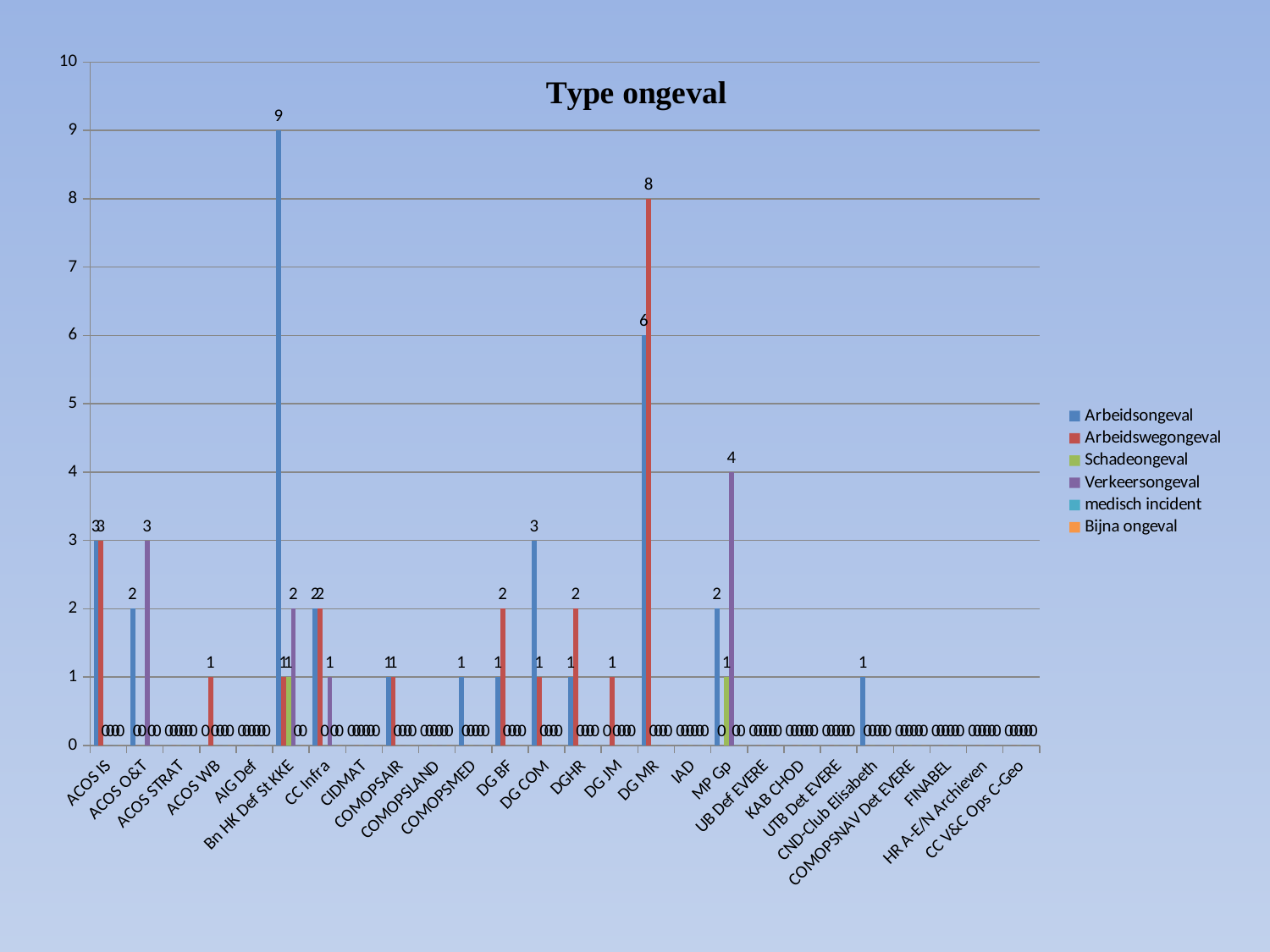
Which category has the highest Arbeidsongeval value? Bn HK Def St KKE What is the Arbeidsongeval value for Bn HK Def St KKE? 9 For DG MR, what is the difference between the Arbeidswegongeval value and the Arbeidsongeval value? 2 What is the Verkeersongeval value for MP Gp? 4 What kind of chart is shown on the slide? bar chart How many series does the legend list? 6 Which is larger: the Arbeidsongeval value for Bn HK Def St KKE or the Arbeidswegongeval value for DG MR? Arbeidsongeval for Bn HK Def St KKE Which category has the highest Arbeidswegongeval value? DG MR How many categories are shown on the x axis? 26 What is the title of the chart? Type ongeval What is the Arbeidsongeval value for DG COM? 3 What is the Arbeidswegongeval value for DG MR? 8